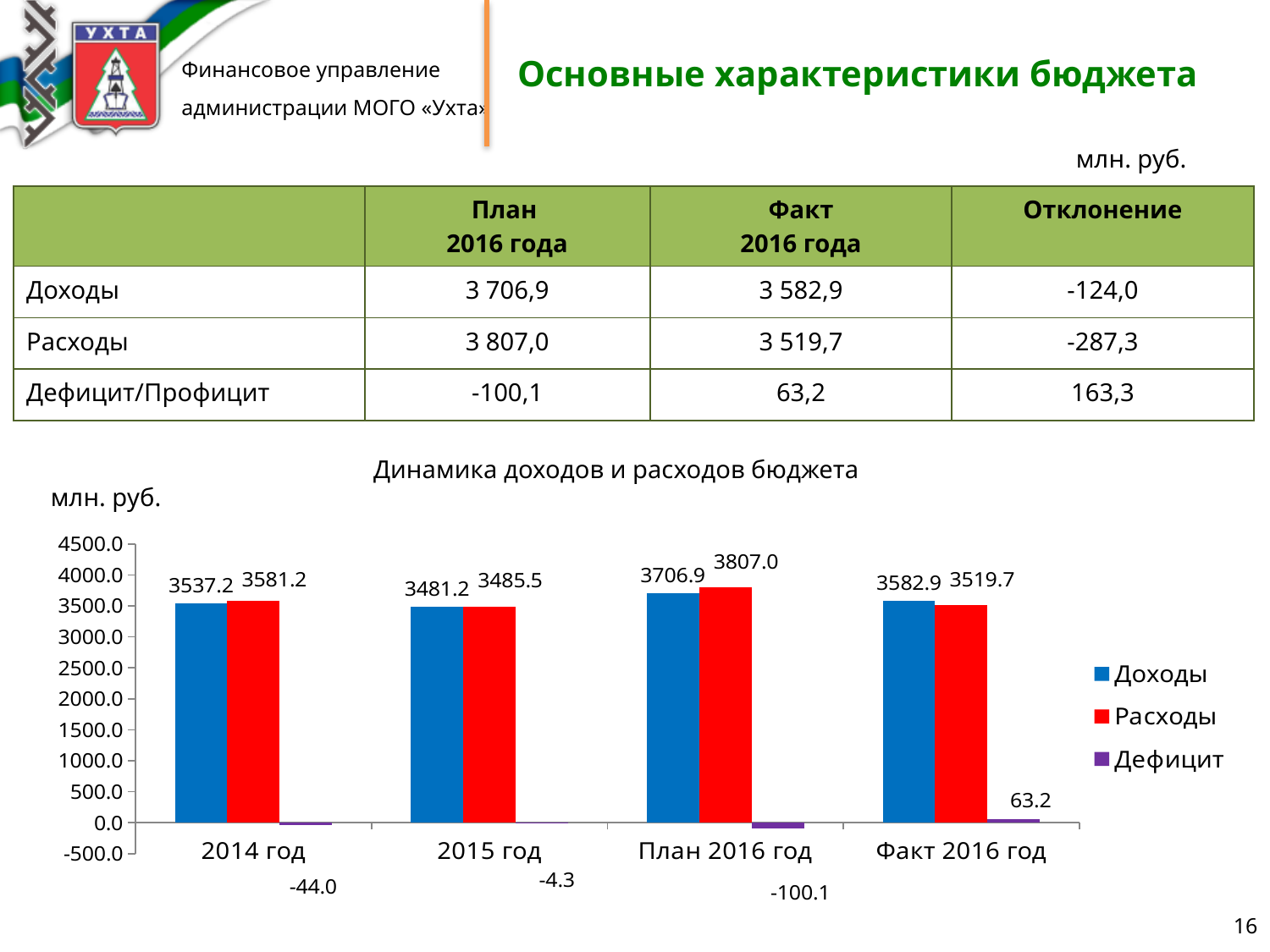
What is the value of Дефицит for Факт 2016 год in the chart? 63.2 What is the title of the chart? Динамика доходов и расходов бюджета How many series does the chart legend list? 3 What is the value of Расходы for План 2016 год in the chart? 3807.0 What is the value of Доходы for 2014 год in the chart? 3537.2 Which is larger for Факт 2016 год: Доходы or Расходы? Доходы What type of chart is shown on the slide? bar chart Which category has the lowest Расходы value in the chart? 2015 год What is the difference between Расходы and Доходы for План 2016 год in the chart? 100.1 How many categories are shown on the x axis of the chart? 4 Which category has the highest Доходы value in the chart? План 2016 год What is the value of Дефицит for 2015 год in the chart? -4.3